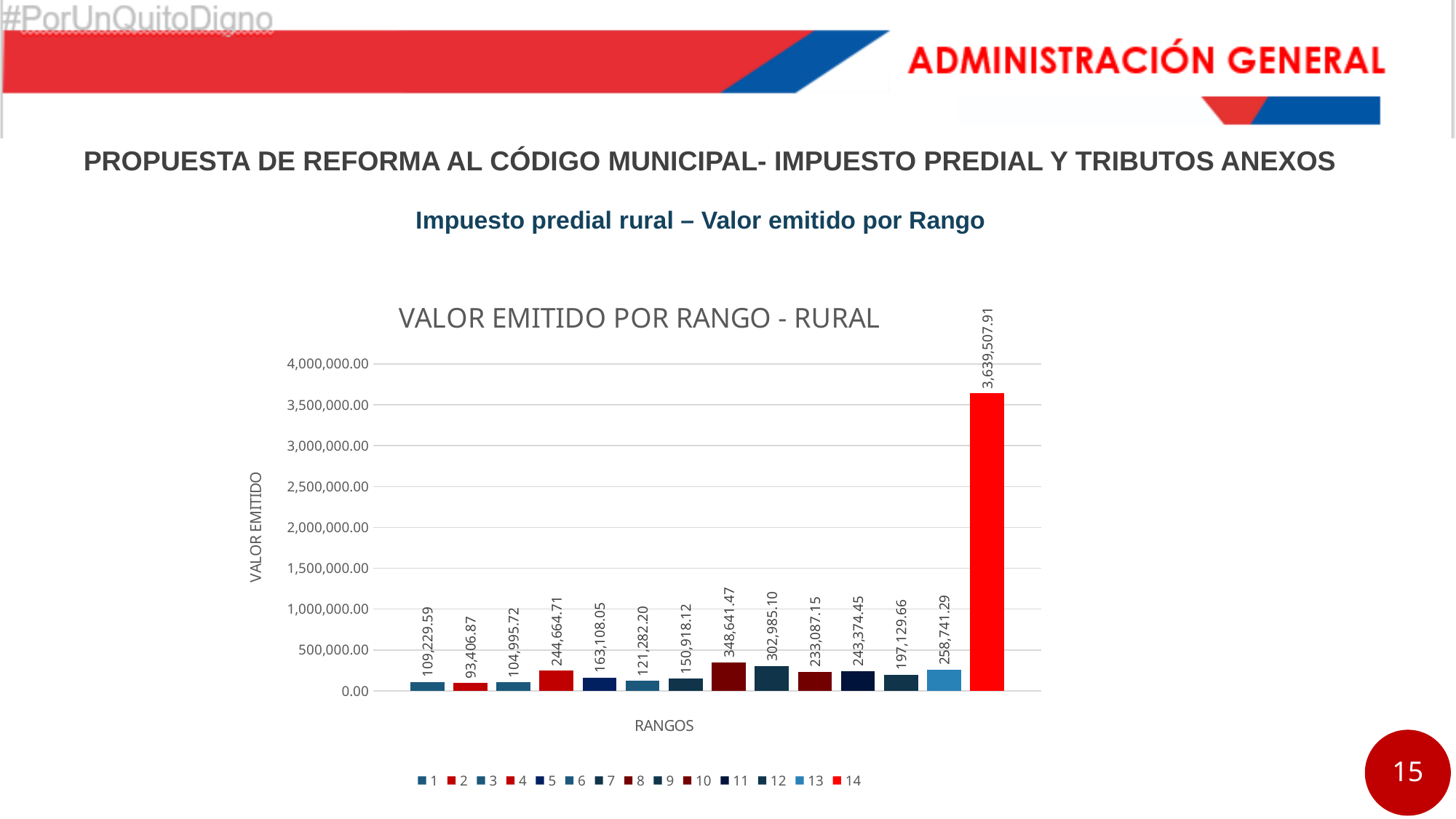
What is the difference between the value for rango 14 and the value for rango 8? 3,290,866.44 What is the value emitted for rango 8? 348,641.47 What is the difference between the value for rango 4 and the value for rango 2? 151,257.84 Which rango has the highest value emitted? 14 What is the value emitted for rango 2? 93,406.87 What kind of chart is VALOR EMITIDO POR RANGO - RURAL? bar chart What is the value emitted for rango 13? 258,741.29 Which has a larger value emitted, rango 9 or rango 10? 9 Which rango has the lowest value emitted? 2 What is the value emitted for rango 14 in the VALOR EMITIDO POR RANGO - RURAL chart? 3,639,507.91 How many rangos are plotted in the chart? 14 Is the value for rango 14 greater or less than 3,500,000.00? greater